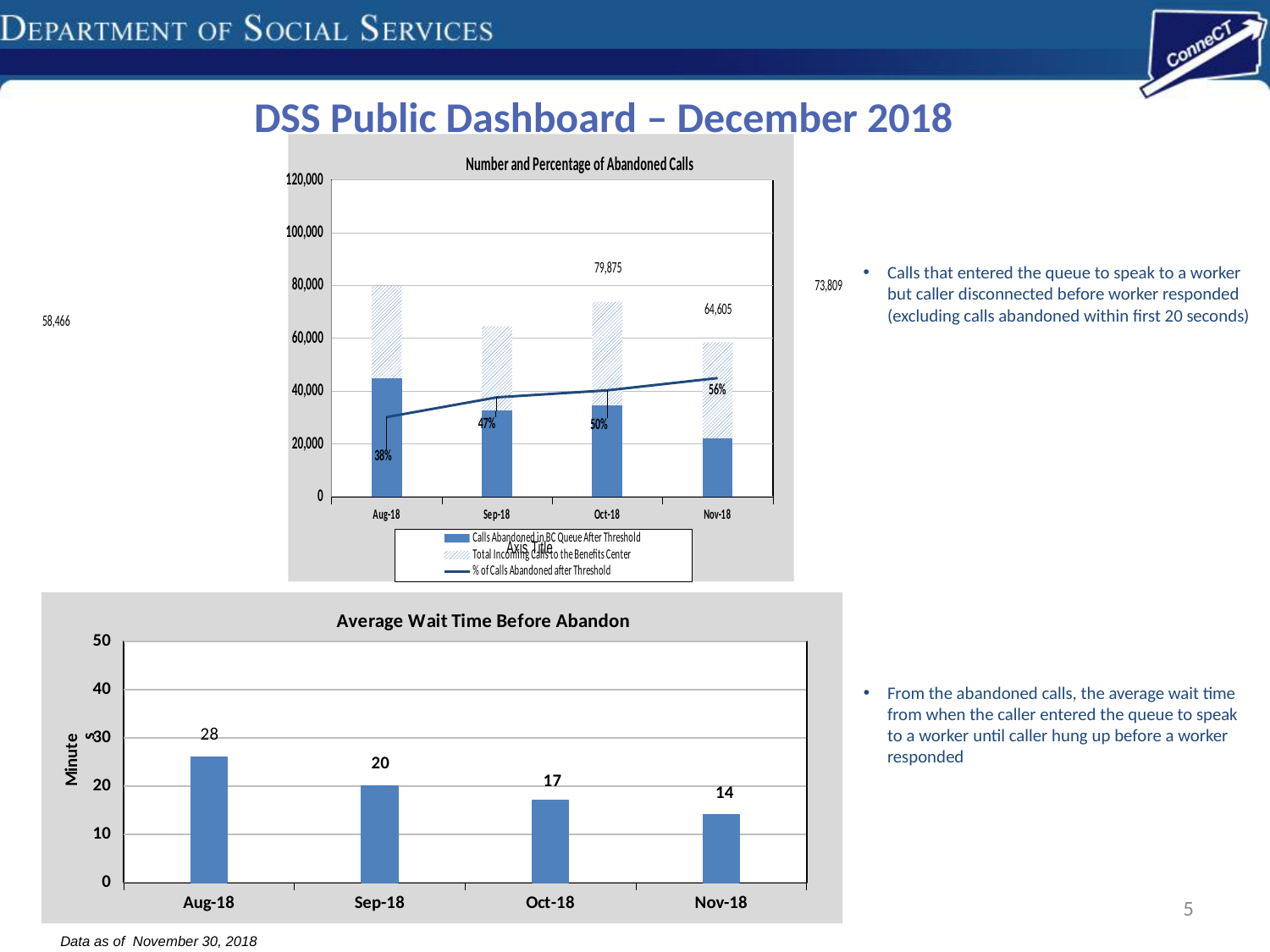
In the 'Average Wait Time Before Abandon' chart, what is the value for Aug-18? 28 In the 'Average Wait Time Before Abandon' chart, do the values rise or fall from Aug-18 to Nov-18? fall In the 'Average Wait Time Before Abandon' chart, which month has the highest value? Aug-18 In the 'Number and Percentage of Abandoned Calls' chart, what is the % of Calls Abandoned after Threshold for Nov-18? 56% In the 'Average Wait Time Before Abandon' chart, which month has the lowest value? Nov-18 How many months are shown in the 'Average Wait Time Before Abandon' chart? 4 In the 'Number and Percentage of Abandoned Calls' chart, what is the % of Calls Abandoned after Threshold for Aug-18? 38% What kind of chart is the 'Average Wait Time Before Abandon' chart? bar chart In the 'Average Wait Time Before Abandon' chart, what is the value for Nov-18? 14 In the 'Average Wait Time Before Abandon' chart, what is the difference between the Aug-18 and Nov-18 values? 14 How many series does the legend of the 'Number and Percentage of Abandoned Calls' chart list? 3 In the 'Number and Percentage of Abandoned Calls' chart, is the value of Calls Abandoned in BC Queue After Threshold for Nov-18 greater or less than 40,000? less